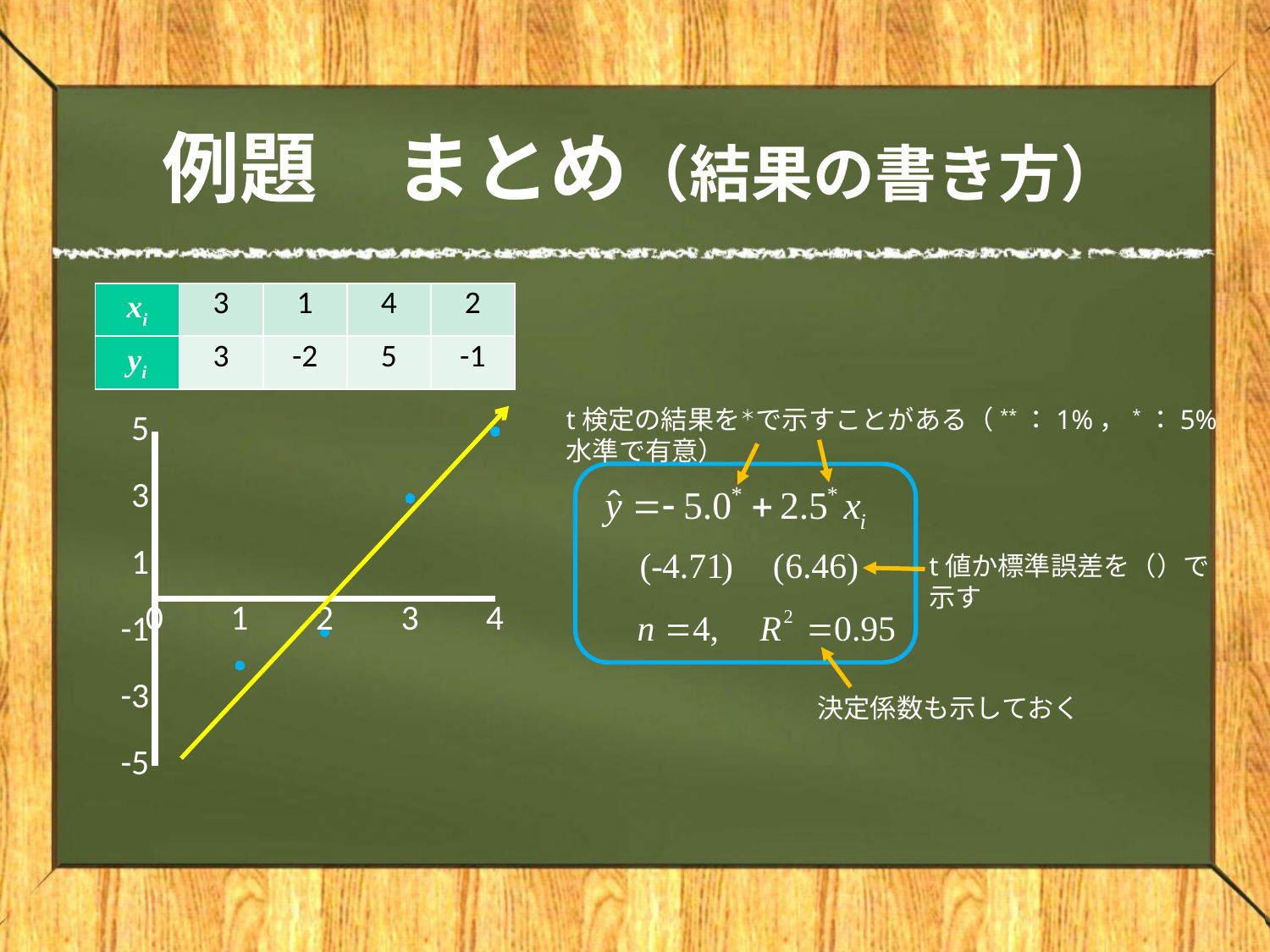
In the scatter chart, what is the y value of the point at x = 1? -2 How many data points are plotted in the scatter chart? 4 What kind of chart is shown on the slide? scatter chart In the scatter chart, what is the y value of the point at x = 3? 3 In the scatter chart, what is the y value of the point at x = 2? -1 In the scatter chart, what is the y value of the point at x = 4? 5 Which x value has the highest y value in the scatter chart? 4 Which x value has the lowest y value in the scatter chart? 1 What is the difference between the y values at x = 4 and x = 3 in the scatter chart? 2 What is the highest value shown on the y axis of the scatter chart? 5 Is the y value at x = 1 greater or less than 1 in the scatter chart? less Do the y values rise or fall as x increases in the scatter chart? rise